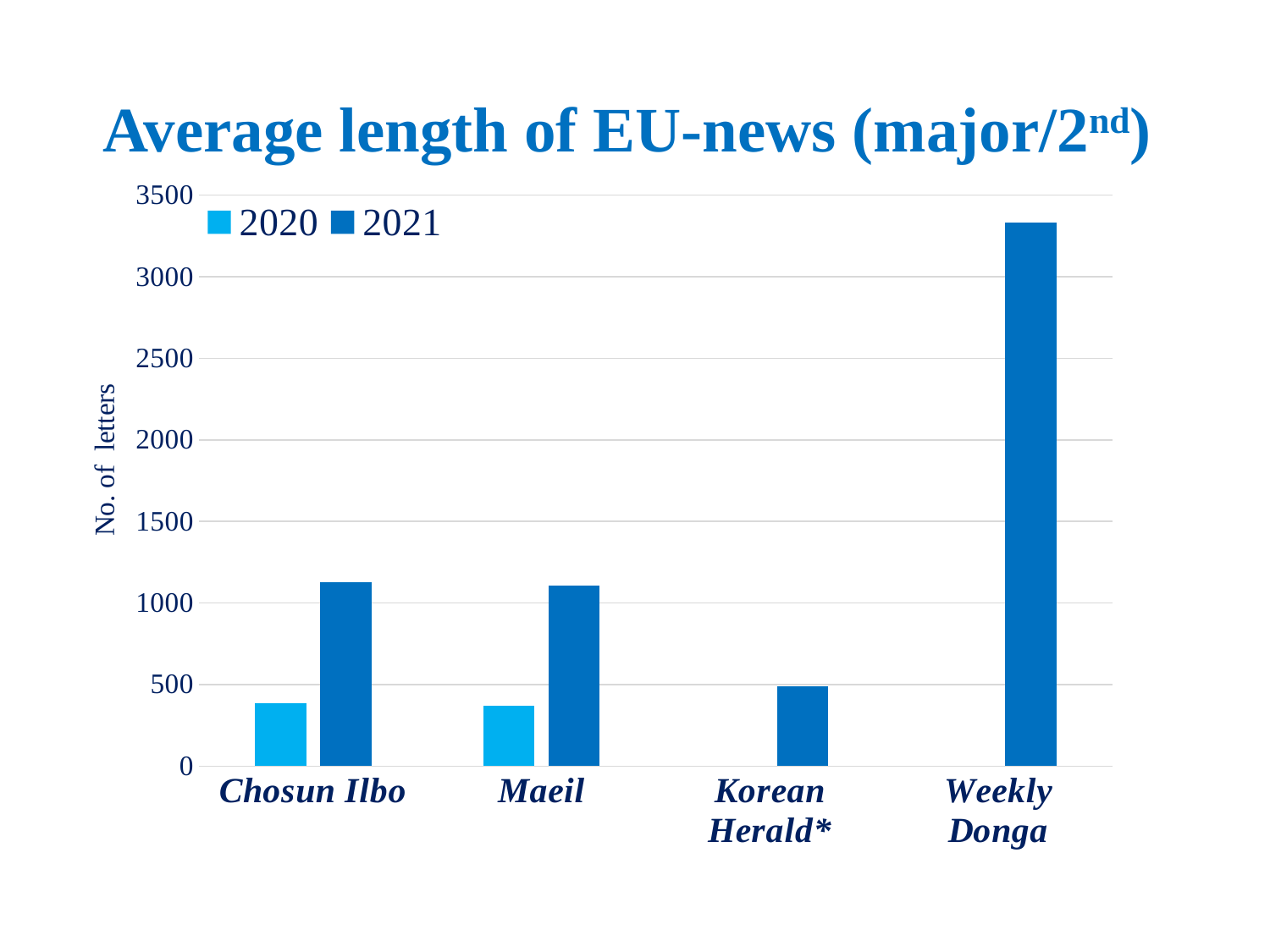
Is the 2020 value for Chosun Ilbo greater or less than 500? less For Chosun Ilbo, which is larger: the 2020 value or the 2021 value? 2021 What kind of chart is shown on the slide? bar chart What is the label on the vertical axis? No. of letters Is the 2021 value for Korean Herald* greater or less than 1000? less Which newspaper has the lowest 2021 value? Korean Herald* Which is larger: the 2021 value for Weekly Donga or the 2021 value for Maeil? Weekly Donga How many series does the legend list? 2 Is the 2021 value for Weekly Donga greater or less than 3000? greater Which newspaper has the highest 2021 value? Weekly Donga How many newspapers (categories) are shown on the x axis? 4